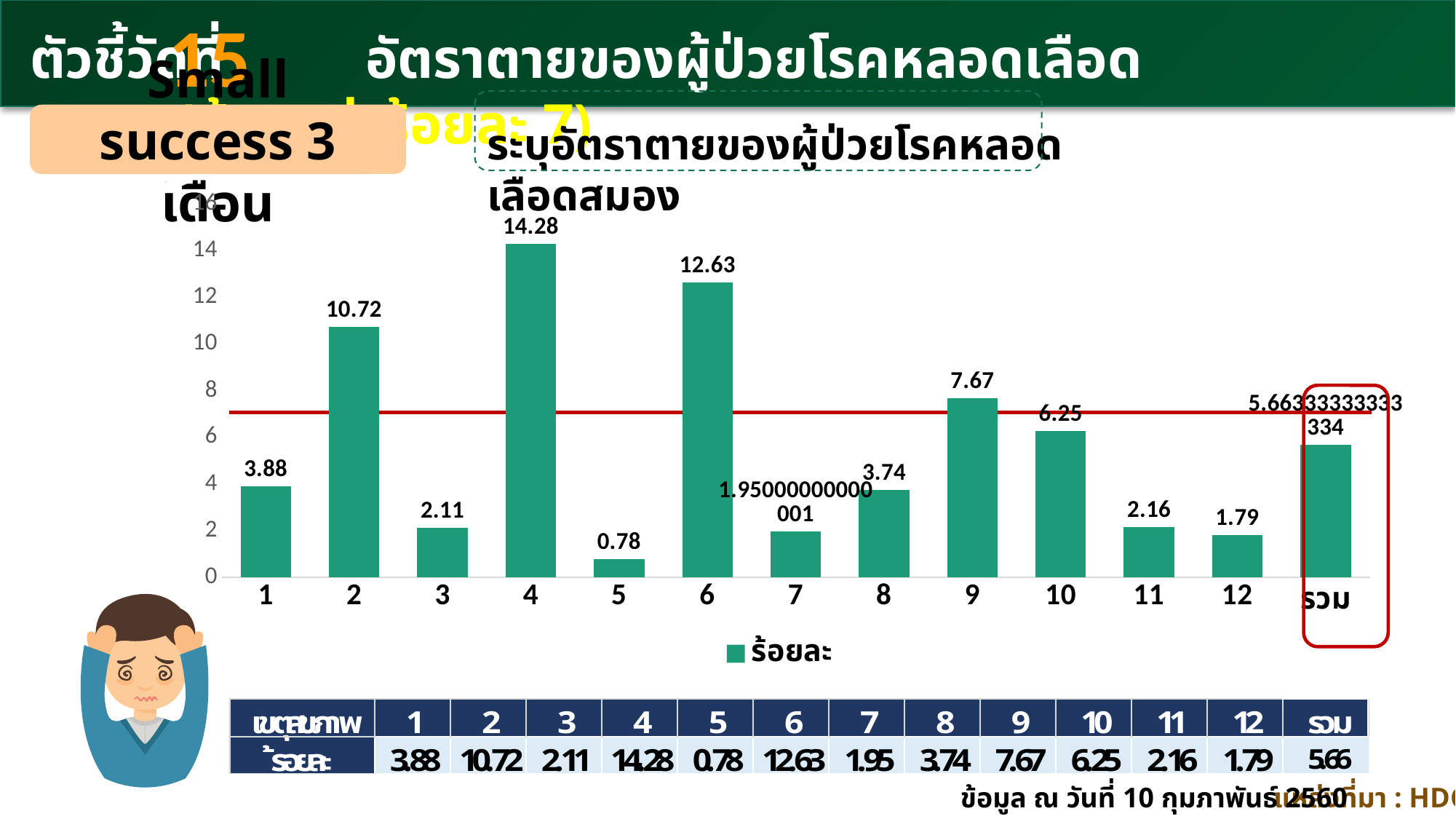
Which category has the lowest value in the chart? 5 Which has the larger value, category 2 or category 6? 6 Which category has the highest value in the chart? 4 Is the value for รวม greater or less than 4? greater What is the value for category 4 in the chart? 14.28 How many categories are plotted along the x axis of the chart? 13 What is the legend entry for the series in the chart? ร้อยละ What kind of chart is shown on the slide? bar chart How many series does the chart legend list? 1 What is the value for category 12 in the chart? 1.79 What is the value for category 2 in the chart? 10.72 What is the difference between the values for category 4 and category 6? 1.65